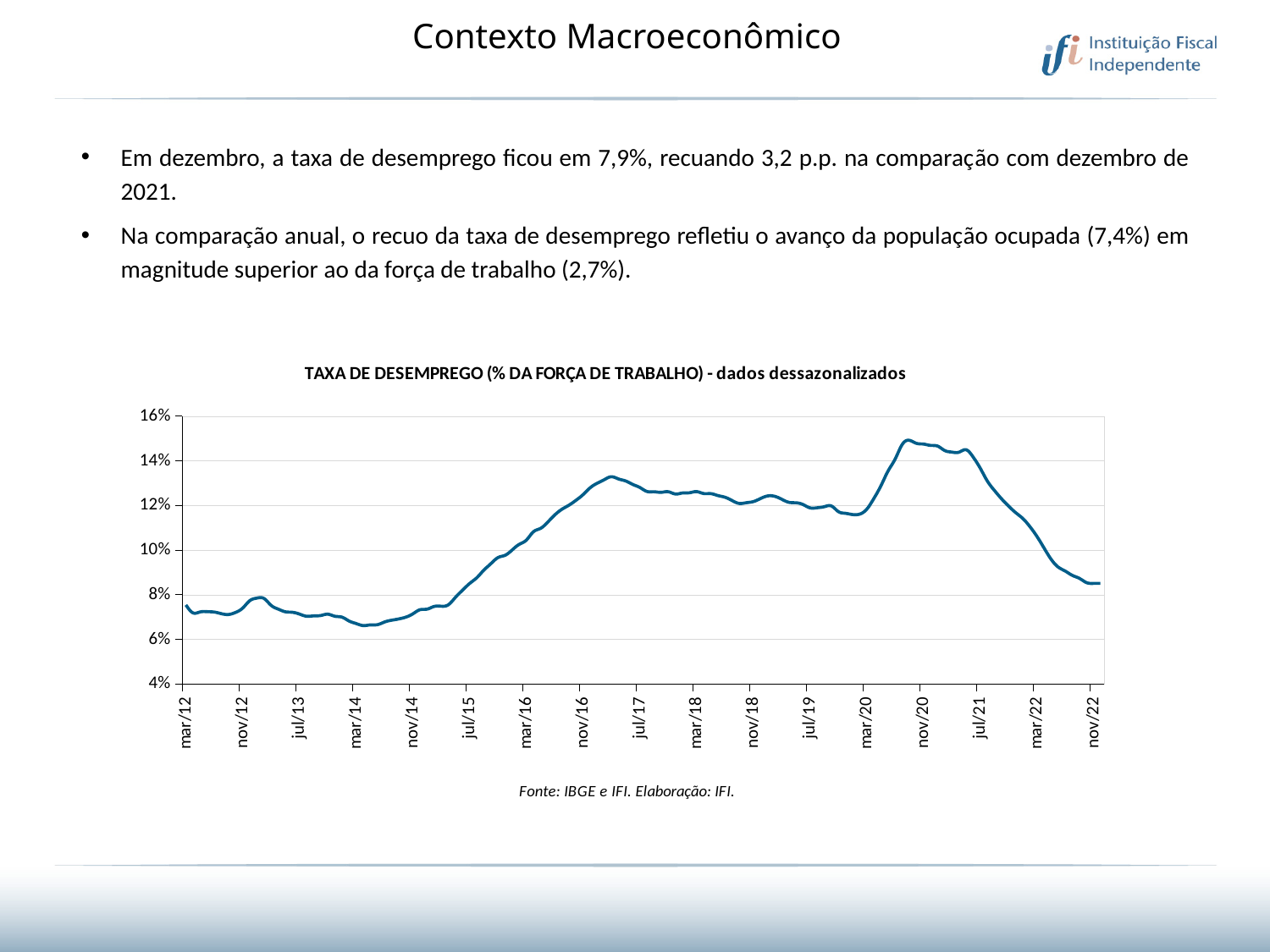
Which is higher, the unemployment rate at mar/12 or at jul/17? jul/17 What kind of chart is shown on the slide? line chart Does the unemployment rate rise or fall between mar/20 and nov/20? rise Which is higher, the unemployment rate at nov/20 or at mar/14? nov/20 Does the unemployment rate rise or fall between nov/20 and nov/22? fall Is the unemployment rate at nov/20 greater or less than 14%? greater Is the unemployment rate at jul/15 greater or less than 10%? less How many date labels are shown on the x axis? 17 Is the unemployment rate at jul/17 greater or less than 12%? greater What is the title of the chart? TAXA DE DESEMPREGO (% DA FORÇA DE TRABALHO) - dados dessazonalizados